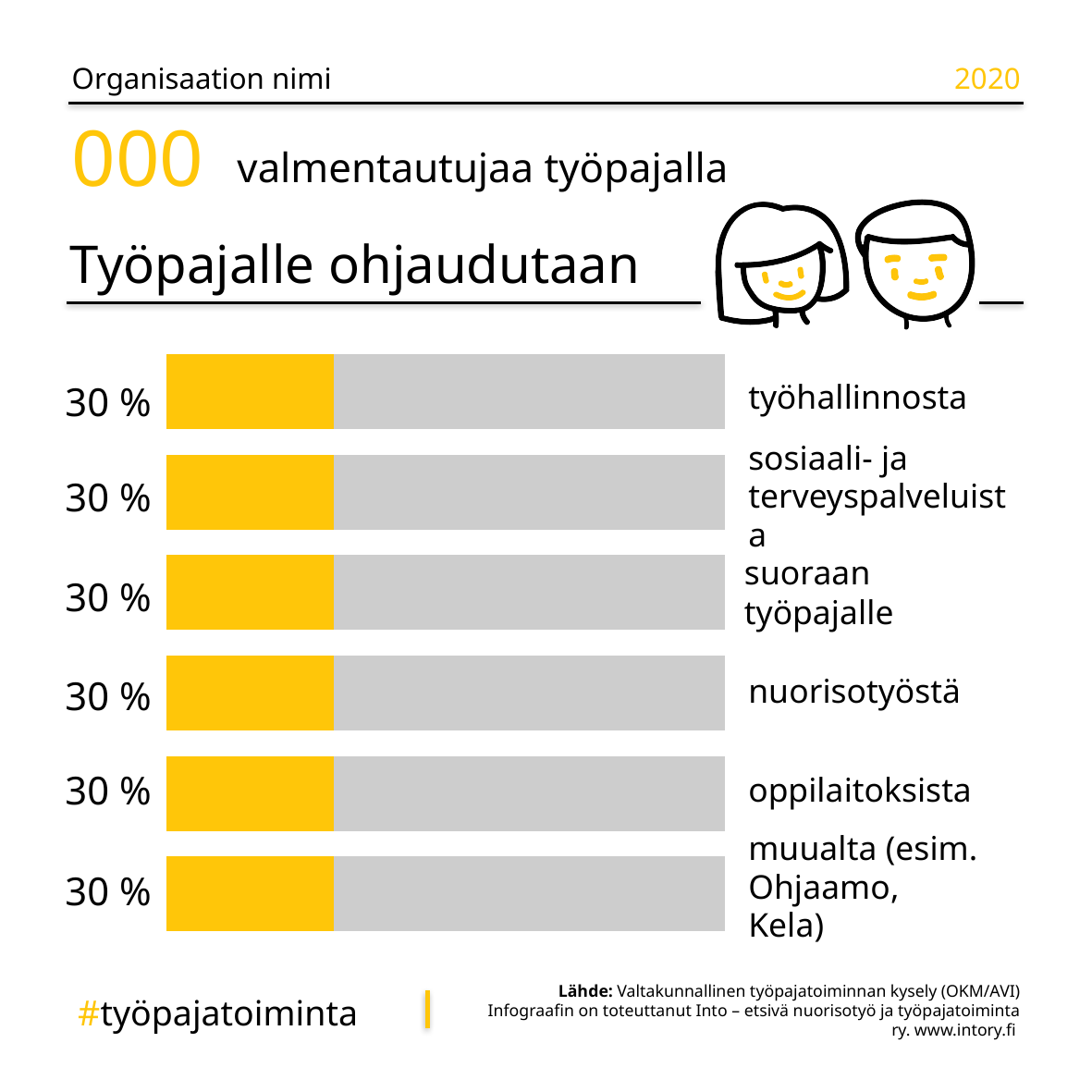
What kind of chart is shown on the slide? bar chart What is the value shown for "nuorisotyöstä"? 30 % What is the value shown for "suoraan työpajalle"? 30 % What is the value shown for "muualta (esim. Ohjaamo, Kela)"? 30 % What is the value shown for "työhallinnosta"? 30 % What is the value shown for "sosiaali- ja terveyspalveluista"? 30 % What is the difference between the values for "työhallinnosta" and "oppilaitoksista"? 0 % What is the title of the chart? Työpajalle ohjaudutaan What is the value shown for "oppilaitoksista"? 30 % Do the values differ between the categories, or are they all the same? all the same What colour is the filled portion of each bar? yellow How many categories are shown in the chart? 6